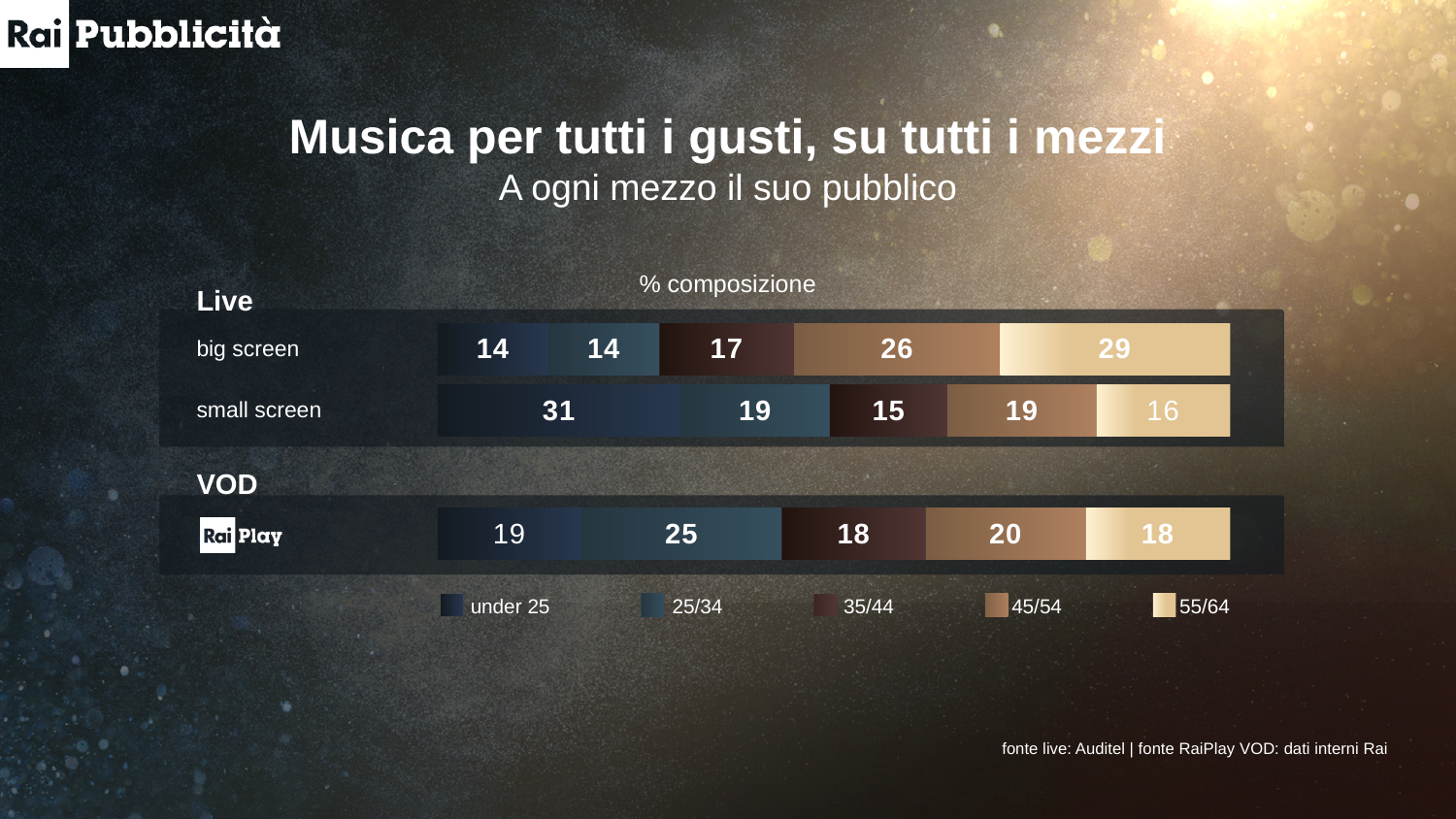
What is the total of the RaiPlay stacked bar? 100 How many stacked bars are shown on the chart? 3 What is the value for the 45/54 segment of the RaiPlay bar? 20 Which age group has the smallest share in the small screen bar? 35/44 How many series does the legend list? 5 What is the value for the 55/64 segment of the big screen bar? 29 What is the value for the under 25 segment of the small screen bar? 31 What is the difference between the under 25 values for small screen and big screen? 17 What is the value for the 25/34 segment of the RaiPlay bar? 25 What kind of chart is shown on the slide? stacked bar chart Which age group has the largest share in the big screen bar? 55/64 Which is larger: the 55/64 value for big screen or the 55/64 value for small screen? big screen